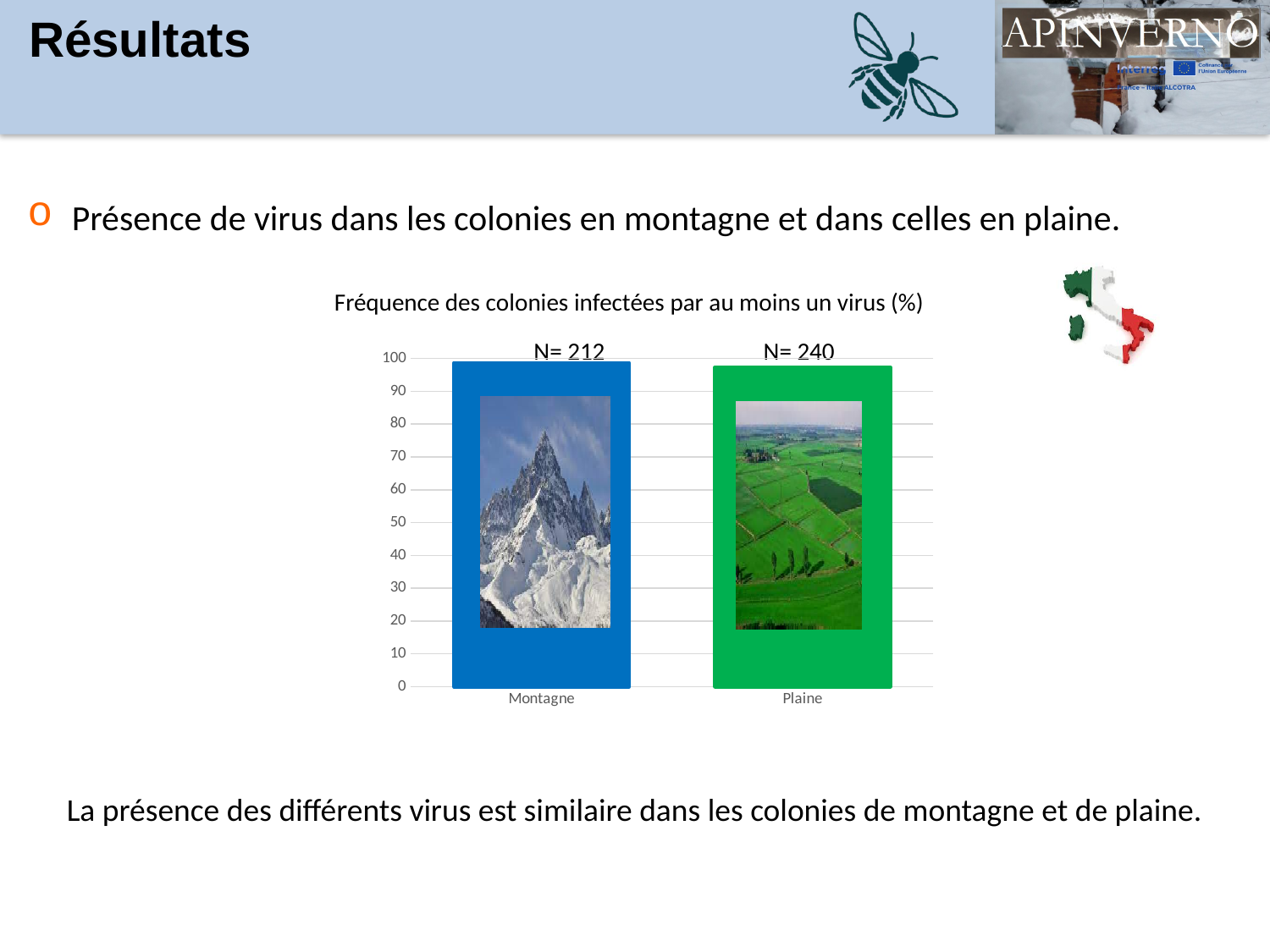
Is the value for Montagne greater or less than 90? greater What sample size (N) is shown above the Montagne bar? N= 212 Is the value for Plaine greater or less than 50? greater Is the value for Plaine greater or less than 90? greater What sample size (N) is shown above the Plaine bar? N= 240 What is the title of the chart? Fréquence des colonies infectées par au moins un virus (%) What are the two category labels on the x axis of the chart? Montagne and Plaine How many categories are plotted on the x axis of the chart? 2 What kind of chart is shown on the slide? bar chart